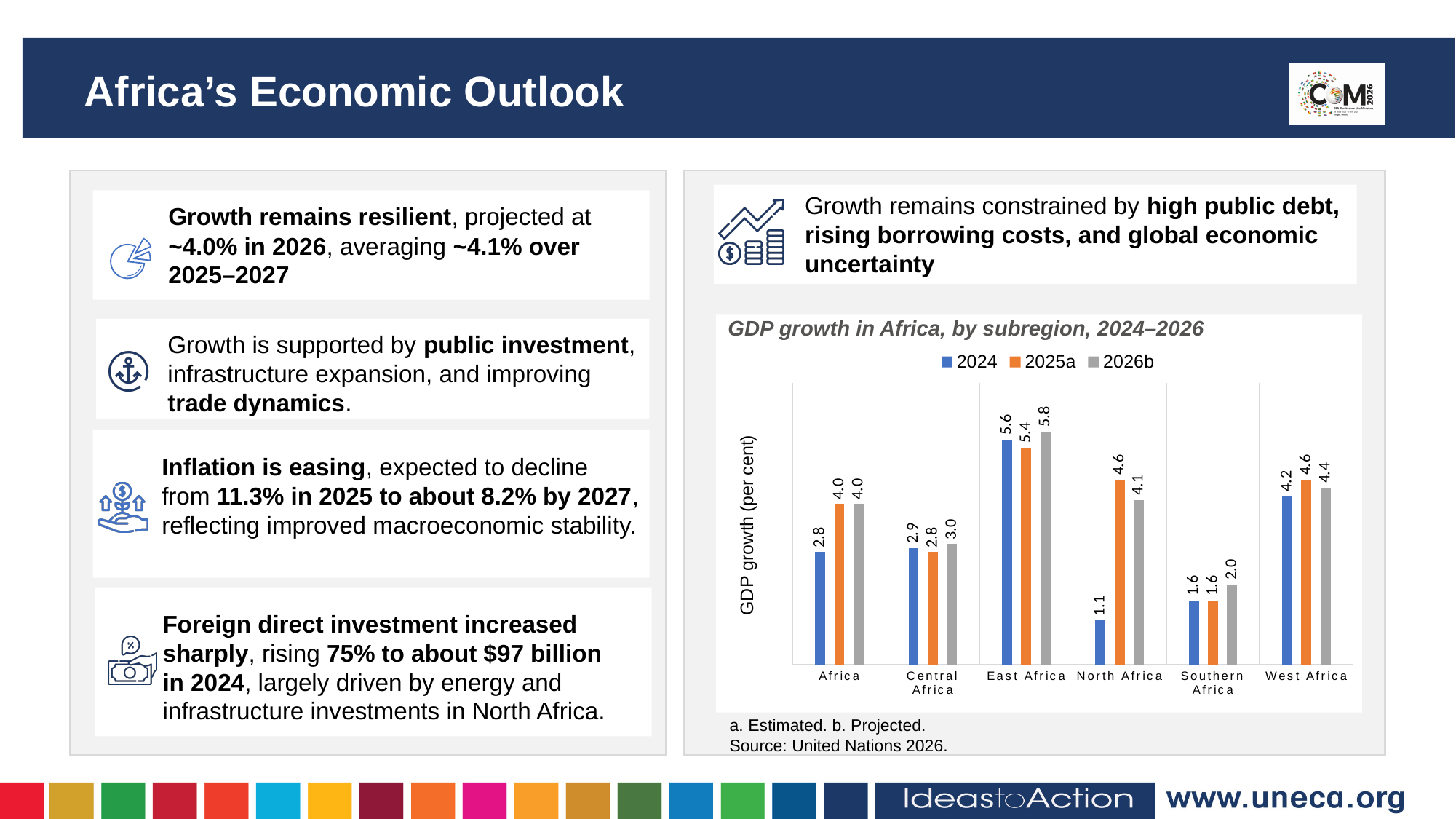
What is the GDP growth value for East Africa in 2024? 5.6 Which is larger: the 2026b value for West Africa or the 2026b value for North Africa? West Africa How many series does the chart legend list? 3 Which category has the lowest GDP growth value in 2024? North Africa What is the GDP growth value for Southern Africa in 2026b? 2.0 Do the GDP growth values for Central Africa rise or fall from 2025a to 2026b? Rise What is the title of the chart? GDP growth in Africa, by subregion, 2024–2026 What type of chart is shown on the slide? Bar chart What is the difference between the 2025a and 2024 GDP growth values for North Africa? 3.5 What is the GDP growth value for North Africa in 2025a? 4.6 How many subregion categories are shown on the x axis of the chart? 6 Which subregion has the highest GDP growth value in 2026b? East Africa